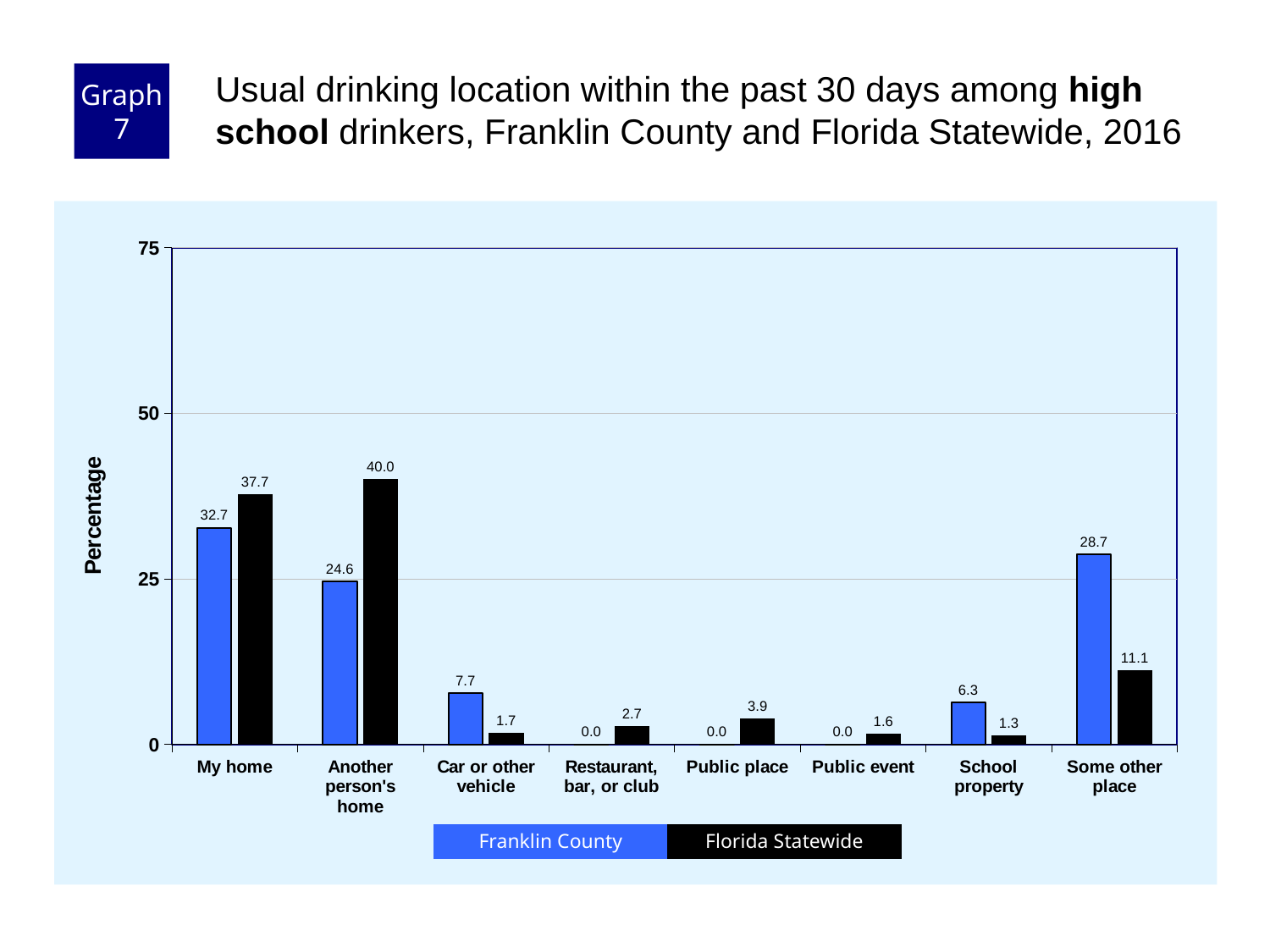
What is the Franklin County value for My home? 32.7 What colour represents Florida Statewide in the legend? black Which category has the highest Florida Statewide value? Another person's home What is the Franklin County value for Some other place? 28.7 What kind of chart is shown? bar chart How many series does the legend list? 2 Which category has the lowest Florida Statewide value? School property How many location categories are shown on the x axis? 8 What is the Florida Statewide value for Another person's home? 40.0 Which is larger for Some other place: Franklin County or Florida Statewide? Franklin County What is the difference between the Florida Statewide and Franklin County values for My home? 5.0 Is the Franklin County value for Another person's home greater or less than 25? less